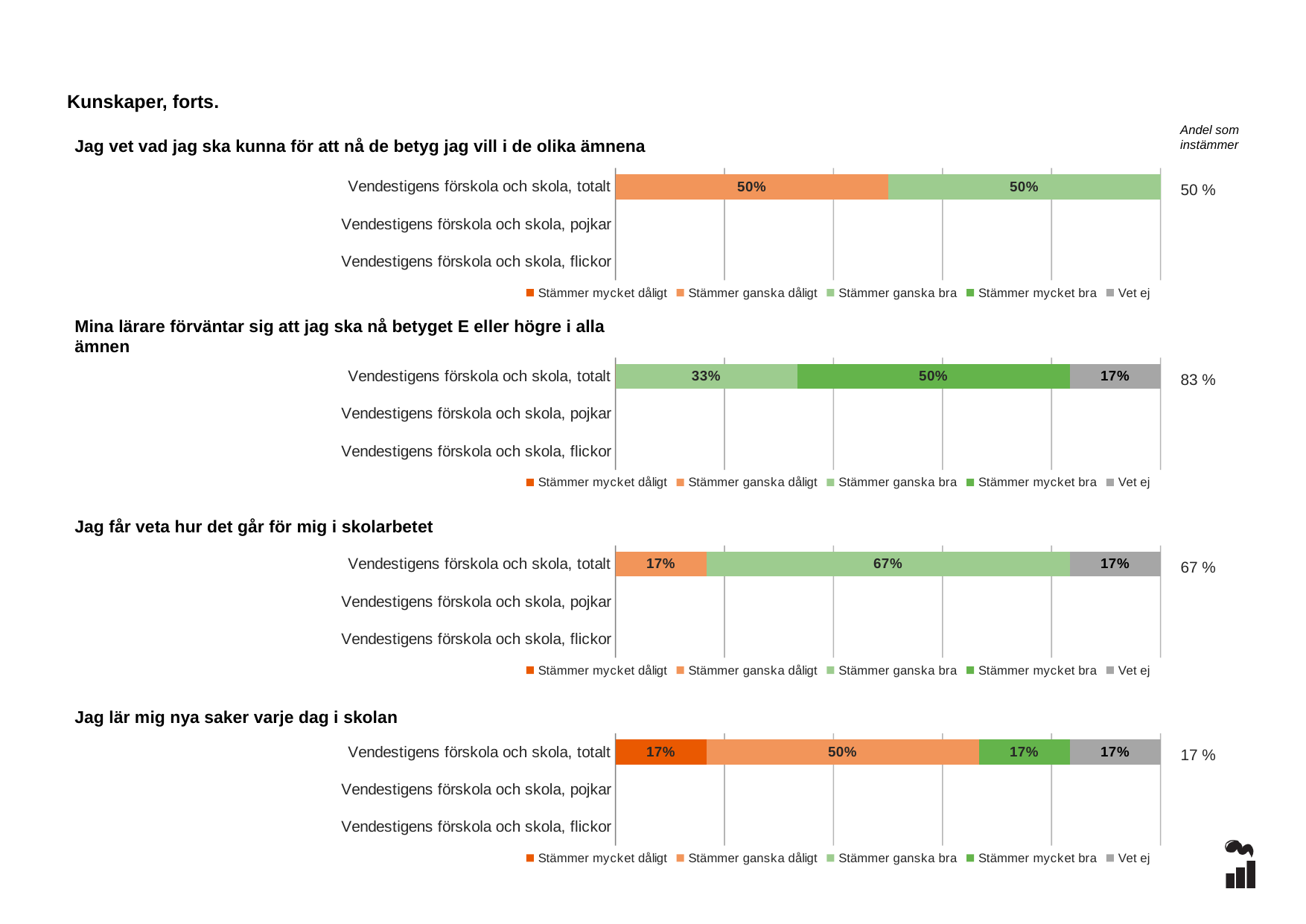
What kind of chart is 'Jag får veta hur det går för mig i skolarbetet'? stacked bar chart In the chart 'Mina lärare förväntar sig att jag ska nå betyget E eller högre i alla ämnen', what is the value of 'Stämmer mycket bra' for 'Vendestigens förskola och skola, totalt'? 50% In the chart 'Jag får veta hur det går för mig i skolarbetet', what is the value of 'Stämmer ganska bra' for 'Vendestigens förskola och skola, totalt'? 67% In the chart 'Mina lärare förväntar sig att jag ska nå betyget E eller högre i alla ämnen', what is the difference between 'Stämmer mycket bra' and 'Stämmer ganska bra' for 'Vendestigens förskola och skola, totalt'? 17% In the chart 'Mina lärare förväntar sig att jag ska nå betyget E eller högre i alla ämnen', what is the value of 'Vet ej' for 'Vendestigens förskola och skola, totalt'? 17% In the chart 'Jag lär mig nya saker varje dag i skolan', which segment of the 'Vendestigens förskola och skola, totalt' bar is the largest? Stämmer ganska dåligt What 'Andel som instämmer' value is shown to the right of the chart 'Mina lärare förväntar sig att jag ska nå betyget E eller högre i alla ämnen'? 83 % How many series does the legend list in the chart 'Jag lär mig nya saker varje dag i skolan'? 5 In the chart 'Jag får veta hur det går för mig i skolarbetet', is 'Stämmer ganska bra' larger or smaller than 'Stämmer ganska dåligt' for 'Vendestigens förskola och skola, totalt'? larger In the chart 'Jag lär mig nya saker varje dag i skolan', what is the value of 'Stämmer ganska dåligt' for 'Vendestigens förskola och skola, totalt'? 50% How many categories are shown on the vertical axis of the chart 'Jag vet vad jag ska kunna för att nå de betyg jag vill i de olika ämnena'? 3 In the chart 'Jag vet vad jag ska kunna för att nå de betyg jag vill i de olika ämnena', what is the value of 'Stämmer ganska bra' for 'Vendestigens förskola och skola, totalt'? 50%